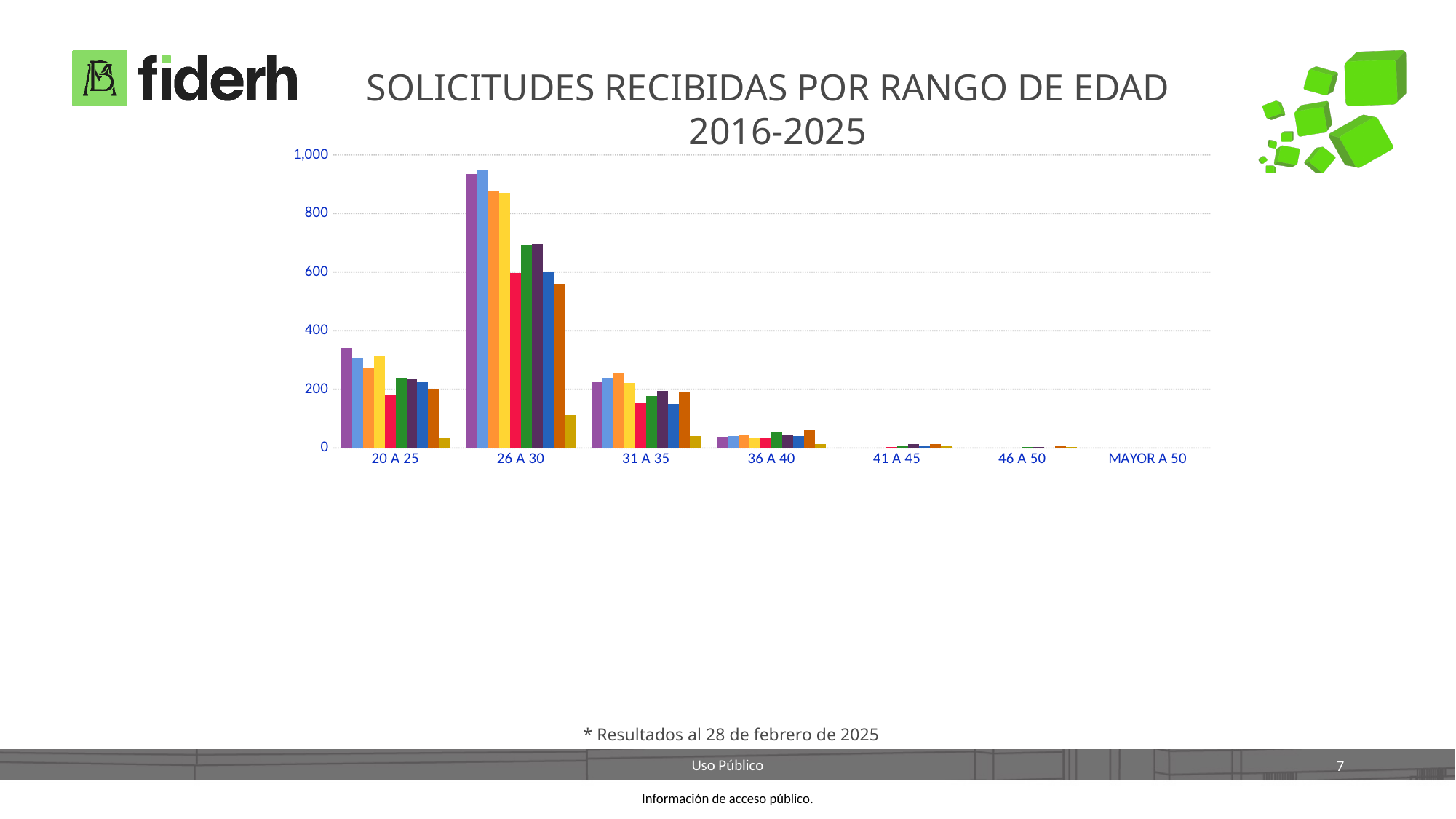
How many age-range categories are shown on the x axis? 7 What is the highest tick value shown on the y axis? 1,000 What is the title of the chart? SOLICITUDES RECIBIDAS POR RANGO DE EDAD 2016-2025 Is the tallest bar for 31 A 35 greater or less than 400? less Is the tallest bar for 26 A 30 greater or less than 800? greater What kind of chart is shown on the slide? Bar chart Do the values rise or fall along the x axis from 26 A 30 to MAYOR A 50? fall Which age range has the highest bars in the chart? 26 A 30 Is the tallest bar for 36 A 40 greater or less than 200? less Which age range has larger values, 20 A 25 or 36 A 40? 20 A 25 Which age range has larger values, 26 A 30 or 31 A 35? 26 A 30